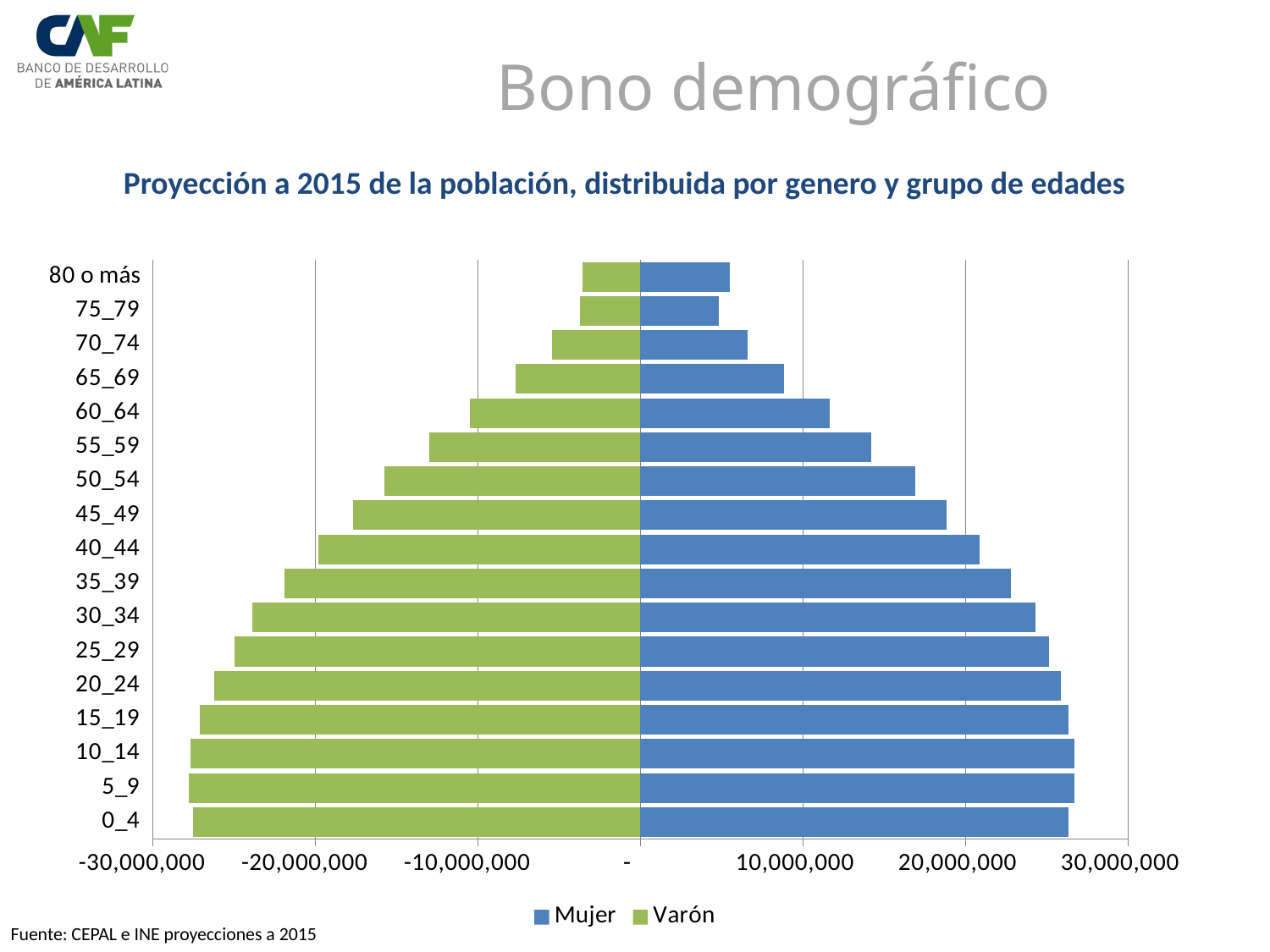
Is the Mujer value for the 0_4 group greater or less than 20,000,000? greater How many age groups are shown on the vertical axis? 17 What is the title of the chart? Proyección a 2015 de la población, distribuida por genero y grupo de edades Do the Mujer values generally increase or decrease as the age groups get older, from 0_4 up to 80 o más? decrease Which has the longer Varón bar, the 30_34 group or the 45_49 group? 30_34 What kind of chart is shown on the slide? bar chart Is the Mujer value for the 55_59 group greater or less than 10,000,000? greater Which has the larger Mujer value, the 50_54 group or the 60_64 group? 50_54 Is the Mujer value for the 80 o más group greater or less than 10,000,000? less Which series is drawn in green? Varón How many series does the legend list? 2